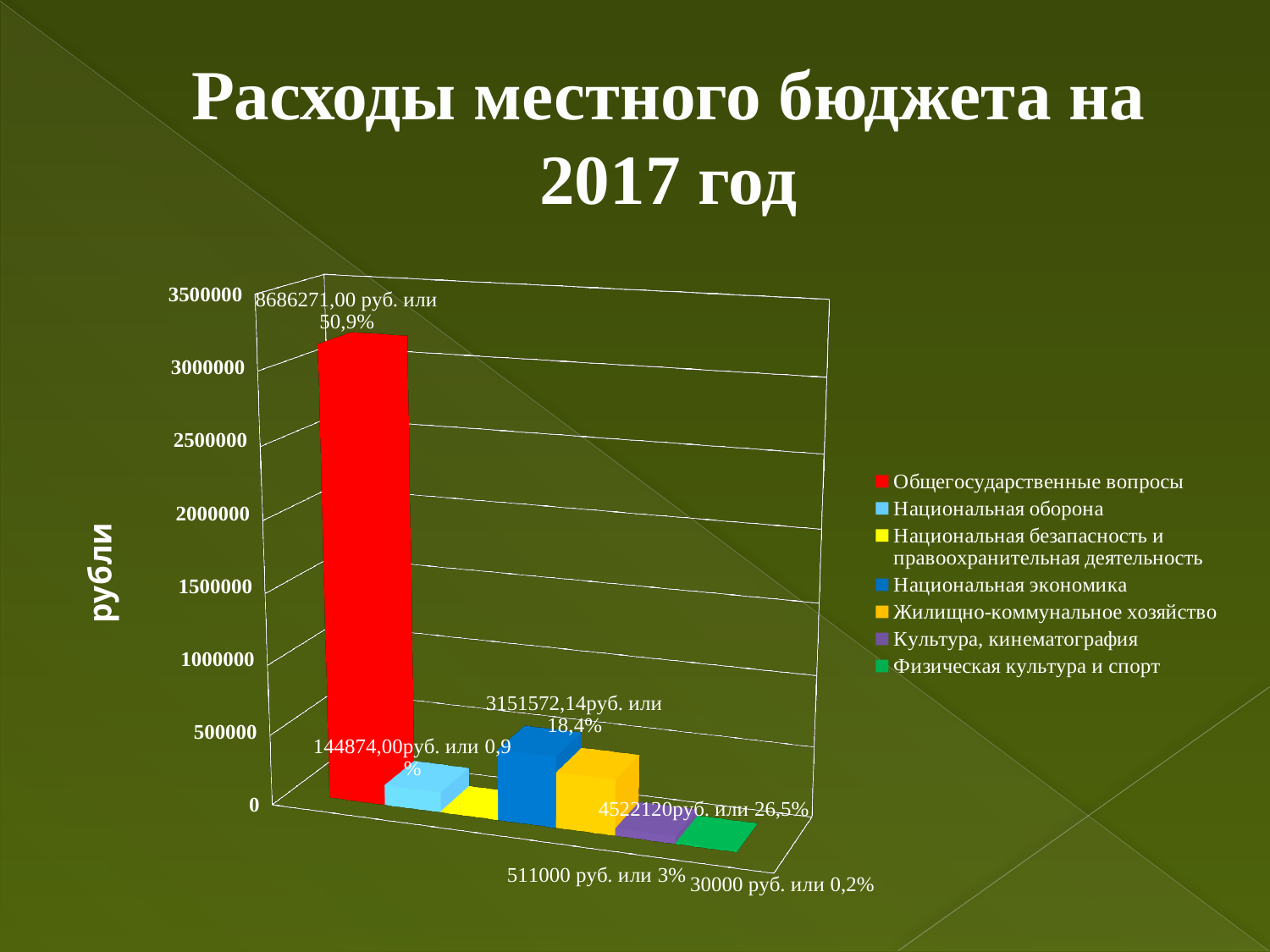
Which series has the tallest bar? Общегосударственные вопросы Is the value for Жилищно-коммунальное хозяйство greater or less than 1000000? less Is the value for Общегосударственные вопросы greater or less than 3000000? greater How many series does the legend list? 7 What data label is printed next to the red bar (Общегосударственные вопросы)? 8686271,00 руб. или 50,9% What kind of chart is shown on the slide? bar chart How many bars are plotted in the chart? 7 Is the value for Национальная экономика greater or less than 1000000? less What is the title of the chart on the slide? Расходы местного бюджета на 2017 год Which is larger, the bar for Национальная экономика or the bar for Национальная оборона? Национальная экономика What label is the vertical axis given? рубли Which is larger, the bar for Общегосударственные вопросы or the bar for Национальная экономика? Общегосударственные вопросы